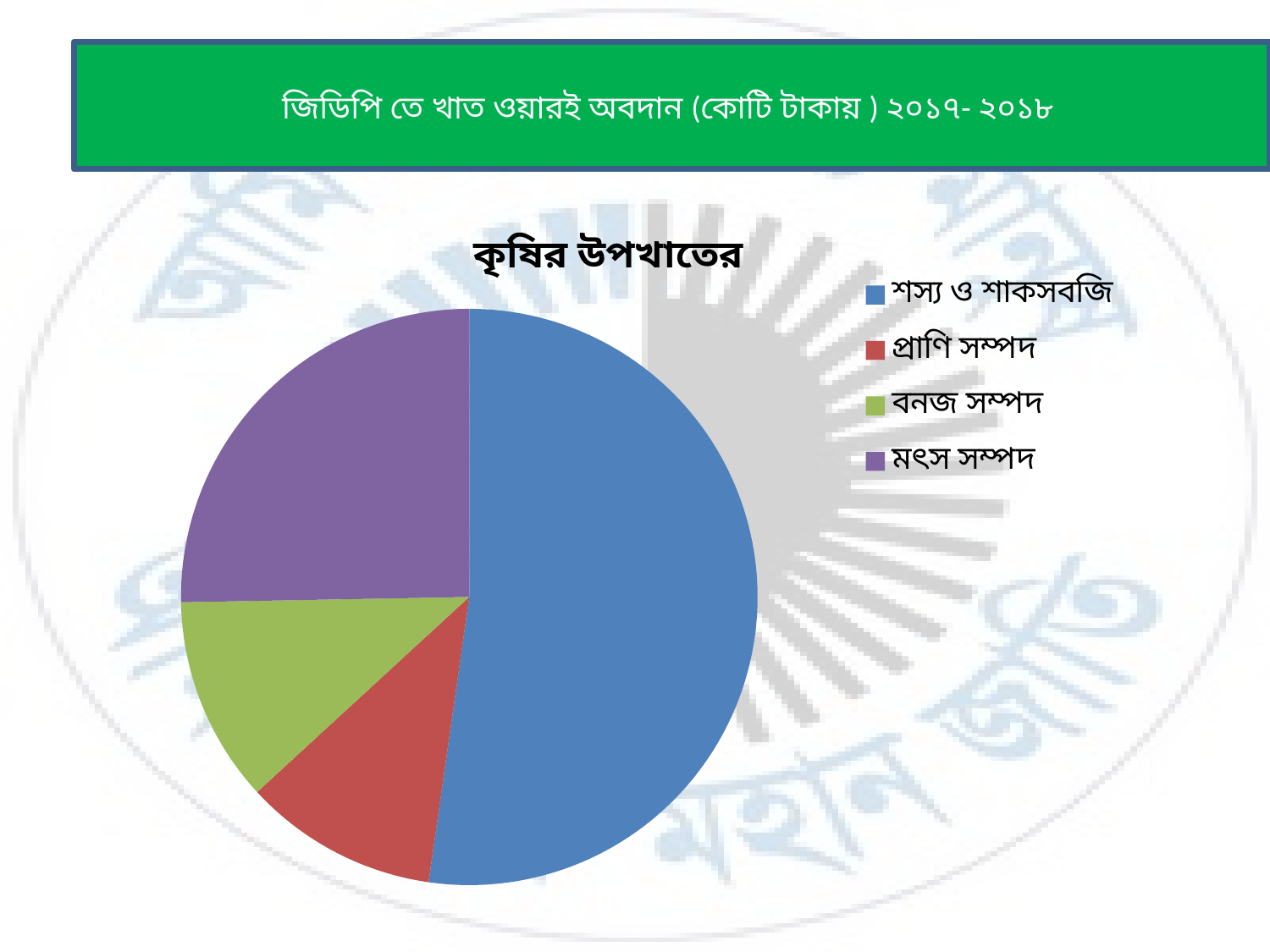
Which slice is larger, শস্য ও শাকসবজি or মৎস সম্পদ? শস্য ও শাকসবজি Which category has the largest slice of the pie chart? শস্য ও শাকসবজি What kind of chart is shown on the slide? pie chart What is the title of the pie chart? কৃষির উপখাতের Which slice is larger, মৎস সম্পদ or প্রাণি সম্পদ? মৎস সম্পদ Which colour represents মৎস সম্পদ in the pie chart? purple Which slice is larger, মৎস সম্পদ or বনজ সম্পদ? মৎস সম্পদ How many categories does the pie chart show? 4